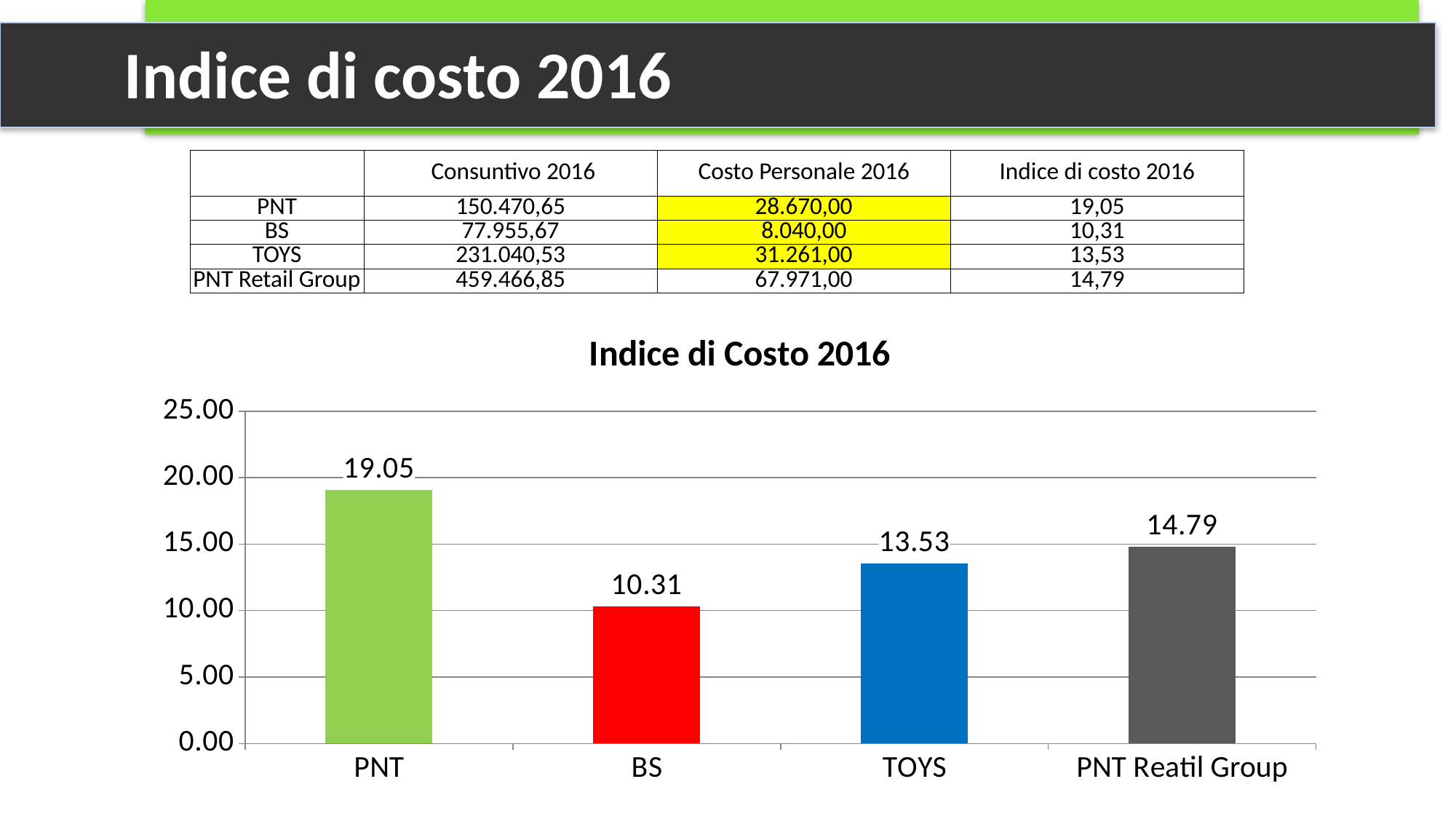
What is the title of the chart on the slide? Indice di Costo 2016 How many categories are shown in the Indice di Costo 2016 chart? 4 Which category has the lowest value in the Indice di Costo 2016 chart? BS Which category has the highest value in the Indice di Costo 2016 chart? PNT Is the value for TOYS in the Indice di Costo 2016 chart greater or less than 15.00? less Which is larger in the Indice di Costo 2016 chart, the value for TOYS or the value for PNT Reatil Group? PNT Reatil Group What kind of chart is the Indice di Costo 2016 chart? bar chart What is the value for PNT in the Indice di Costo 2016 chart? 19.05 What is the difference between the values for PNT and BS in the Indice di Costo 2016 chart? 8.74 What is the value for PNT Reatil Group in the Indice di Costo 2016 chart? 14.79 What is the value for TOYS in the Indice di Costo 2016 chart? 13.53 What is the value for BS in the Indice di Costo 2016 chart? 10.31